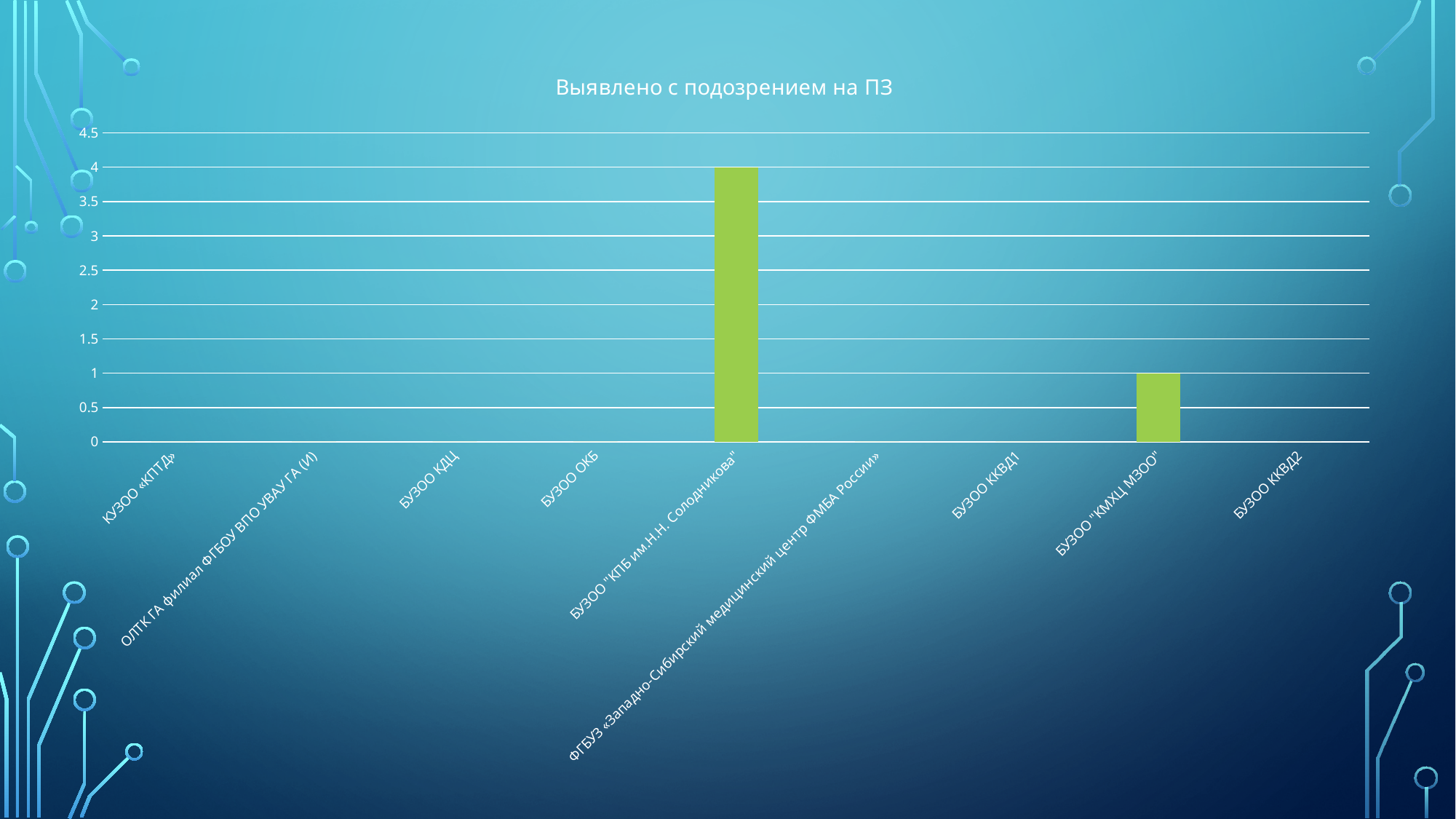
What is the difference between the values for БУЗОО "КПБ им.Н.Н. Солодникова" and БУЗОО "КМХЦ МЗОО"? 3 Which category has the highest value in the chart? БУЗОО "КПБ им.Н.Н. Солодникова" What is the value for БУЗОО "КПБ им.Н.Н. Солодникова"? 4 What kind of chart is shown on the slide? bar chart How many categories are shown on the x axis of the chart? 9 What is the highest value shown on the vertical axis of the chart? 4.5 How many categories in the chart have a visible bar above zero? 2 Is the value for БУЗОО "КПБ им.Н.Н. Солодникова" greater or less than 3? greater What is the value for БУЗОО "КМХЦ МЗОО"? 1 Is the value for БУЗОО "КМХЦ МЗОО" greater or less than 2? less What is the title of the chart? Выявлено с подозрением на ПЗ Which is larger, the value for БУЗОО "КПБ им.Н.Н. Солодникова" or the value for БУЗОО "КМХЦ МЗОО"? БУЗОО "КПБ им.Н.Н. Солодникова"